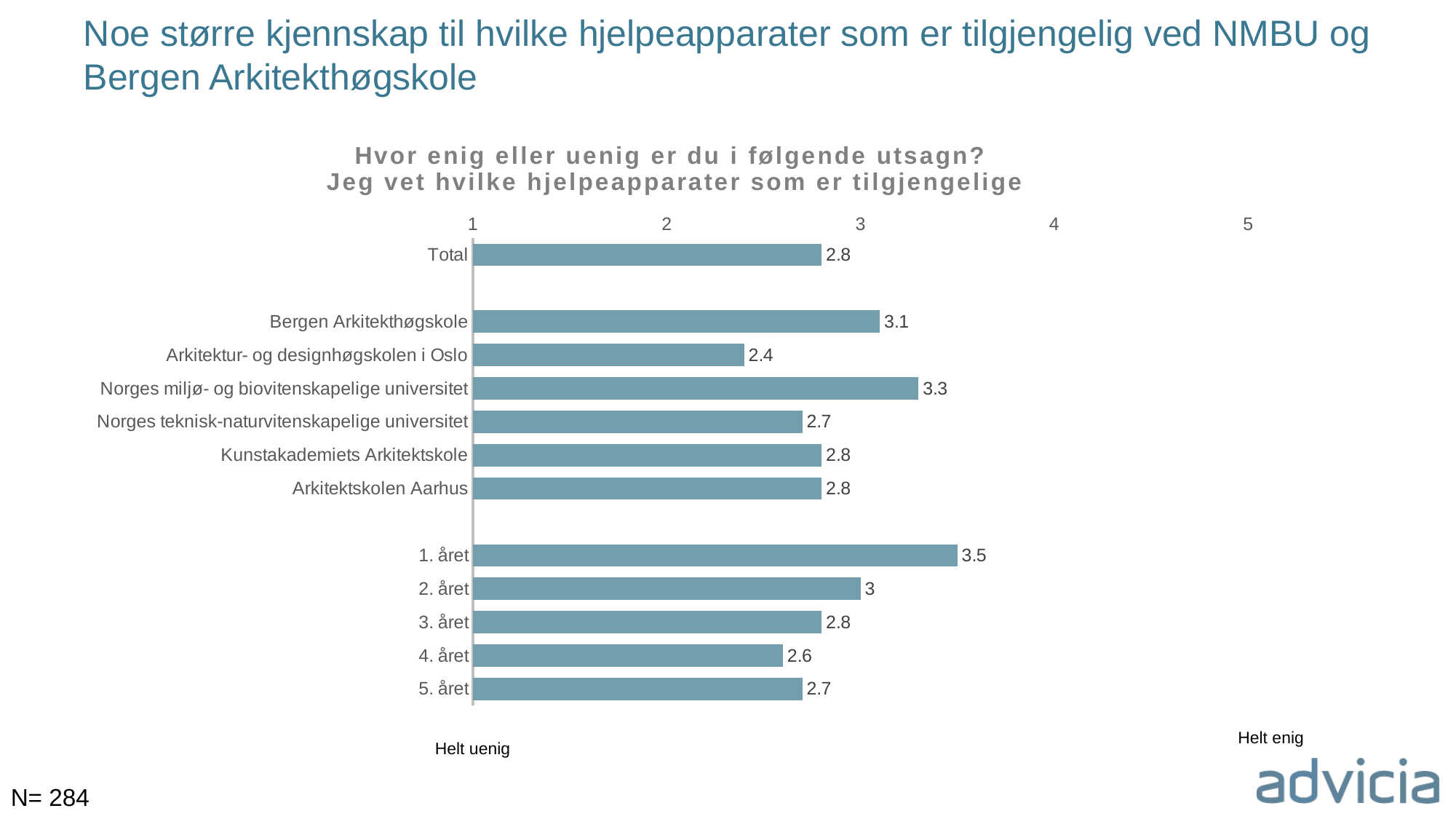
How many bars are shown in the chart? 12 What is the value for 1. året? 3.5 What is the value for Bergen Arkitekthøgskole? 3.1 Which category has the highest value? 1. året What kind of chart is shown on the slide? bar chart Which category has the lowest value? Arkitektur- og designhøgskolen i Oslo What is the difference between the values for Norges miljø- og biovitenskapelige universitet and Norges teknisk-naturvitenskapelige universitet? 0.6 What is the label at the right end of the scale? Helt enig Which is larger, the value for 2. året or the value for 4. året? 2. året What is the value for Arkitektur- og designhøgskolen i Oslo? 2.4 What is the value for Total? 2.8 Is the value for 5. året greater or less than 3? less